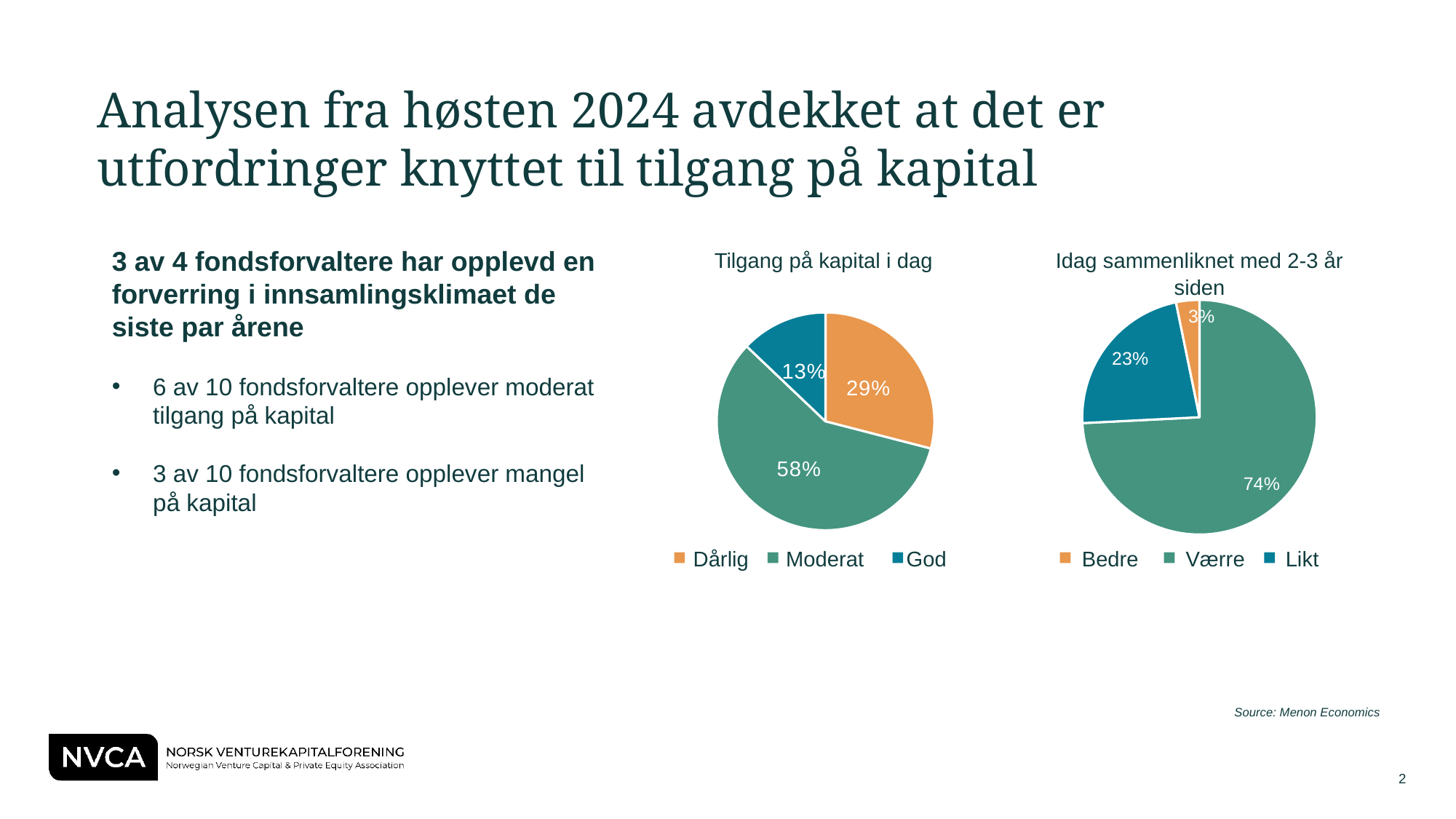
In the chart titled "Idag sammenliknet med 2-3 år siden", what share is labelled Bedre? 3% In the chart titled "Tilgang på kapital i dag", what share is labelled God? 13% In the chart titled "Idag sammenliknet med 2-3 år siden", which category has the smallest slice? Bedre What type of chart is the one titled "Tilgang på kapital i dag"? Pie chart In the chart titled "Idag sammenliknet med 2-3 år siden", what share is labelled Værre? 74% In the chart titled "Tilgang på kapital i dag", what share is labelled Moderat? 58% In the chart titled "Tilgang på kapital i dag", what is the difference in percentage points between Moderat and Dårlig? 29 How many categories does the legend of the chart titled "Idag sammenliknet med 2-3 år siden" list? 3 In the chart titled "Tilgang på kapital i dag", what share is labelled Dårlig? 29% In the chart titled "Idag sammenliknet med 2-3 år siden", which is larger, Likt or Bedre? Likt In the chart titled "Idag sammenliknet med 2-3 år siden", what share is labelled Likt? 23% In the chart titled "Tilgang på kapital i dag", which category has the largest slice? Moderat